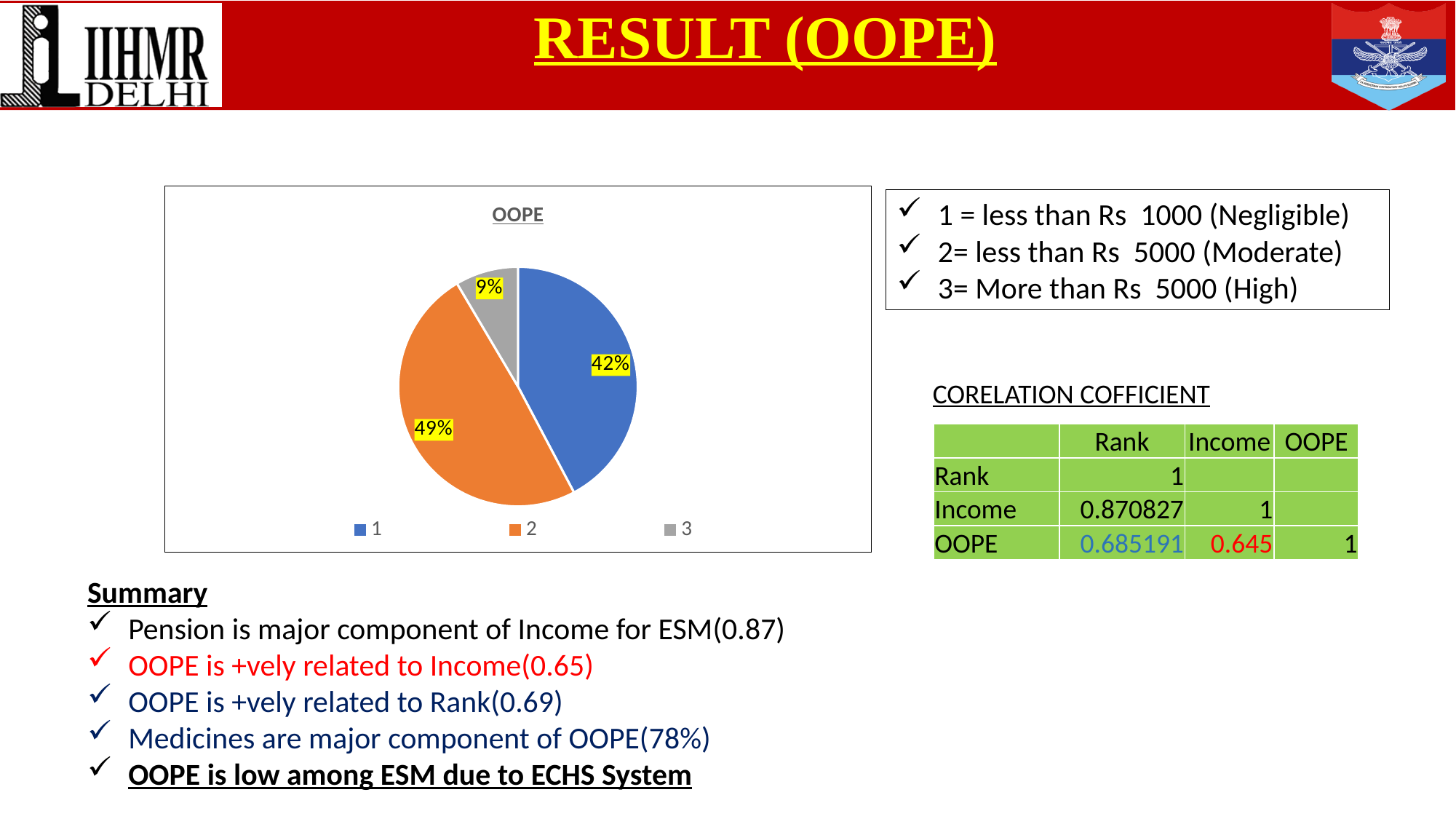
What type of chart is shown on the slide? pie chart What share of the pie does category 2 represent? 49% What share of the pie does category 1 represent? 42% Which category has the largest slice of the pie? 2 How many slices does the pie chart have? 3 Which is larger, the slice for category 1 or the slice for category 3? 1 Which category has the smallest slice of the pie? 3 How many entries does the legend list? 3 What is the difference in percentage points between category 1 and category 3? 33% What share of the pie does category 3 represent? 9% What is the difference in percentage points between category 2 and category 1? 7% What is the title of the chart? OOPE